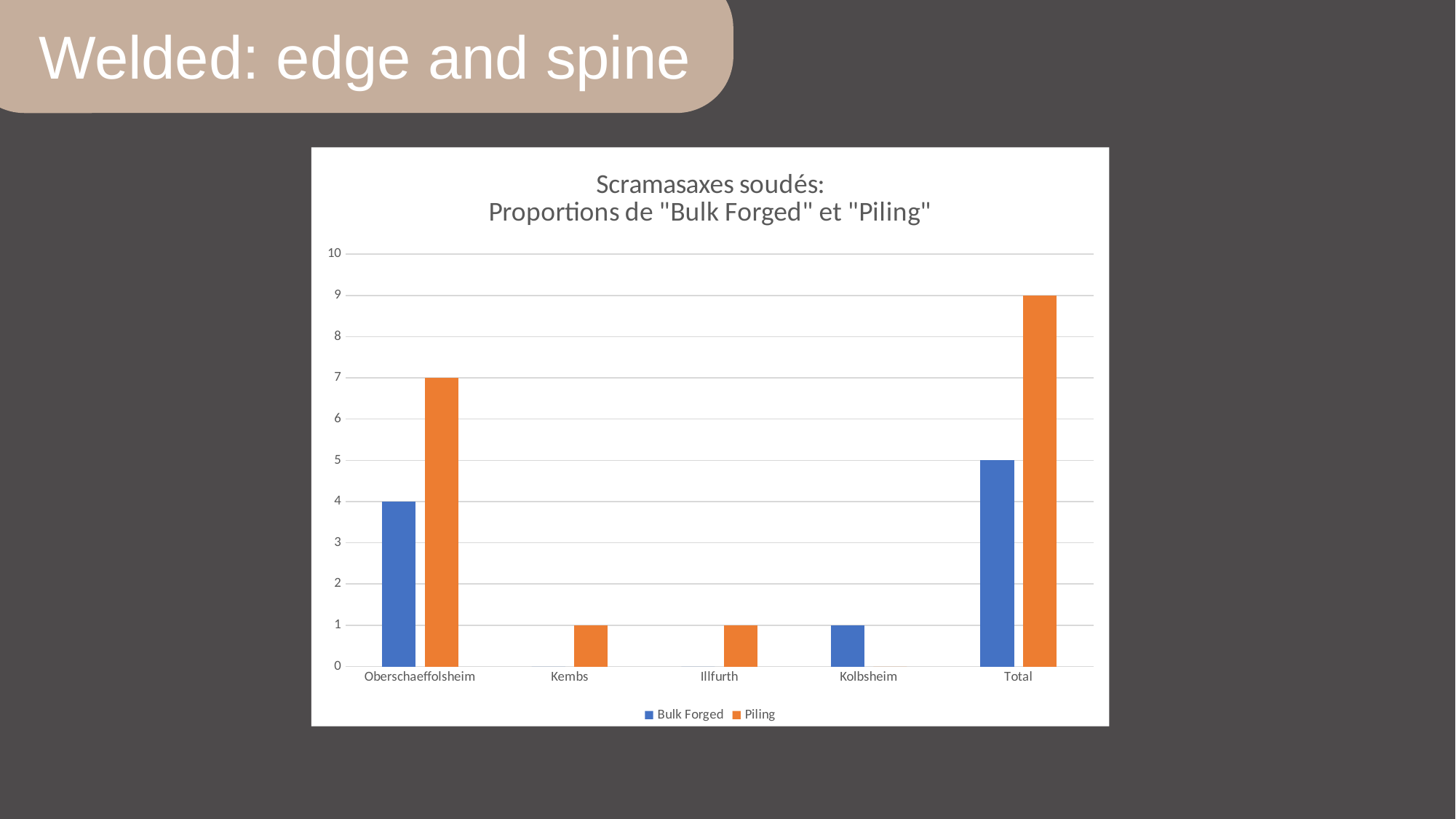
What is the Piling value for Oberschaeffolsheim? 7 What is the Bulk Forged value for Kolbsheim? 1 How many categories are shown on the x axis? 5 Which series is shown in orange in the legend? Piling What is the Bulk Forged value for Oberschaeffolsheim? 4 What type of chart is shown on the slide? bar chart What is the Piling value for Total? 9 Which category has the highest Piling value? Total For Oberschaeffolsheim, which is larger, Bulk Forged or Piling? Piling What is the difference between the Piling and Bulk Forged values for Total? 4 What is the Bulk Forged value for Total? 5 How many series does the legend list? 2